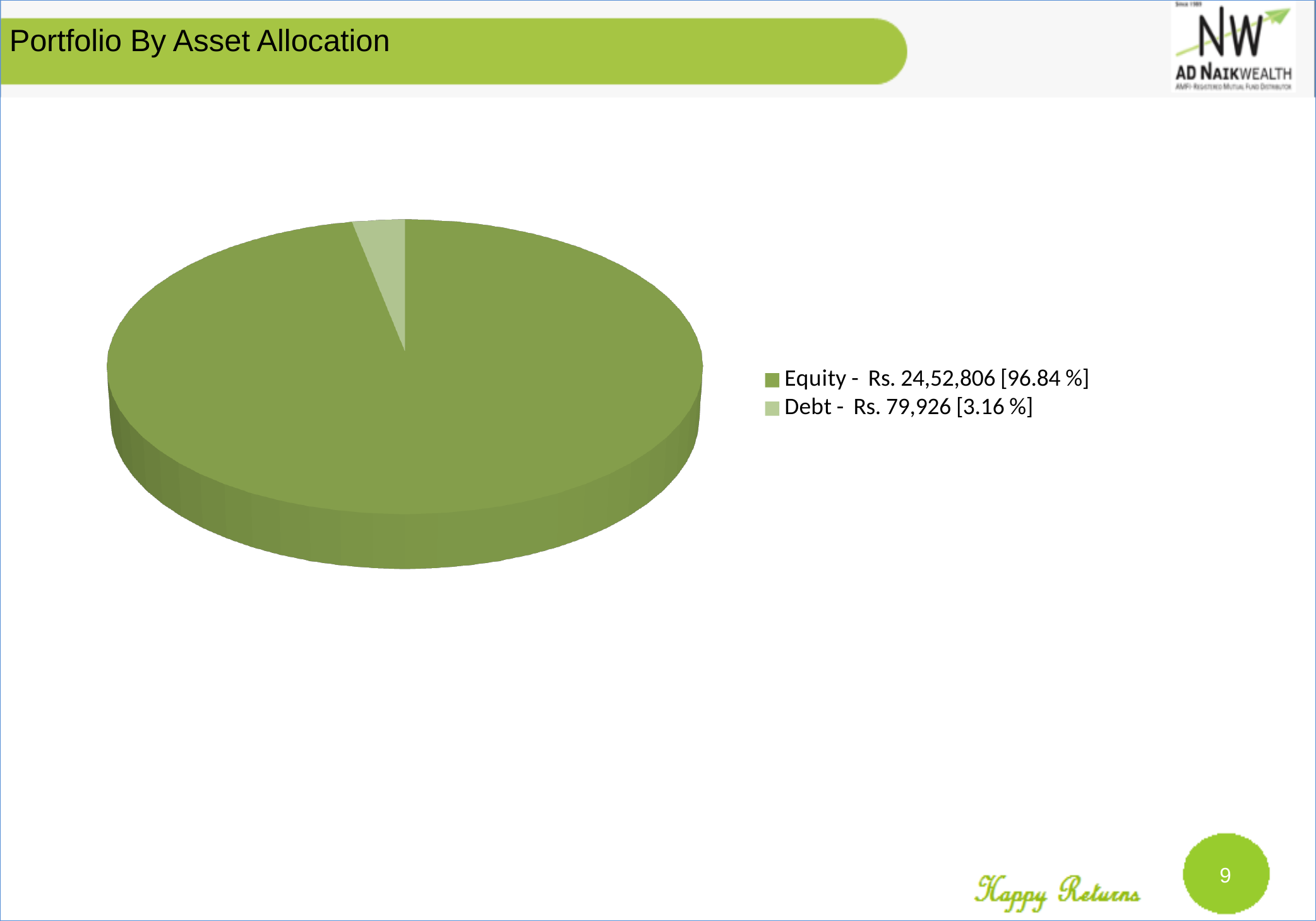
What is the value for Equity? Rs. 24,52,806 What is the value for Debt? Rs. 79,926 What share of the pie does Debt represent? 3.16 % What share of the pie does Equity represent? 96.84 % Which category has the smallest slice? Debt What kind of chart is shown on the slide? Pie chart Which category has the largest slice? Equity What is the difference in percentage share between Equity and Debt? 93.68 % How many categories are shown in the pie chart? 2 Which category is shown in the lighter green colour in the legend? Debt Which is larger, Equity or Debt? Equity What is the title of the slide containing the chart? Portfolio By Asset Allocation